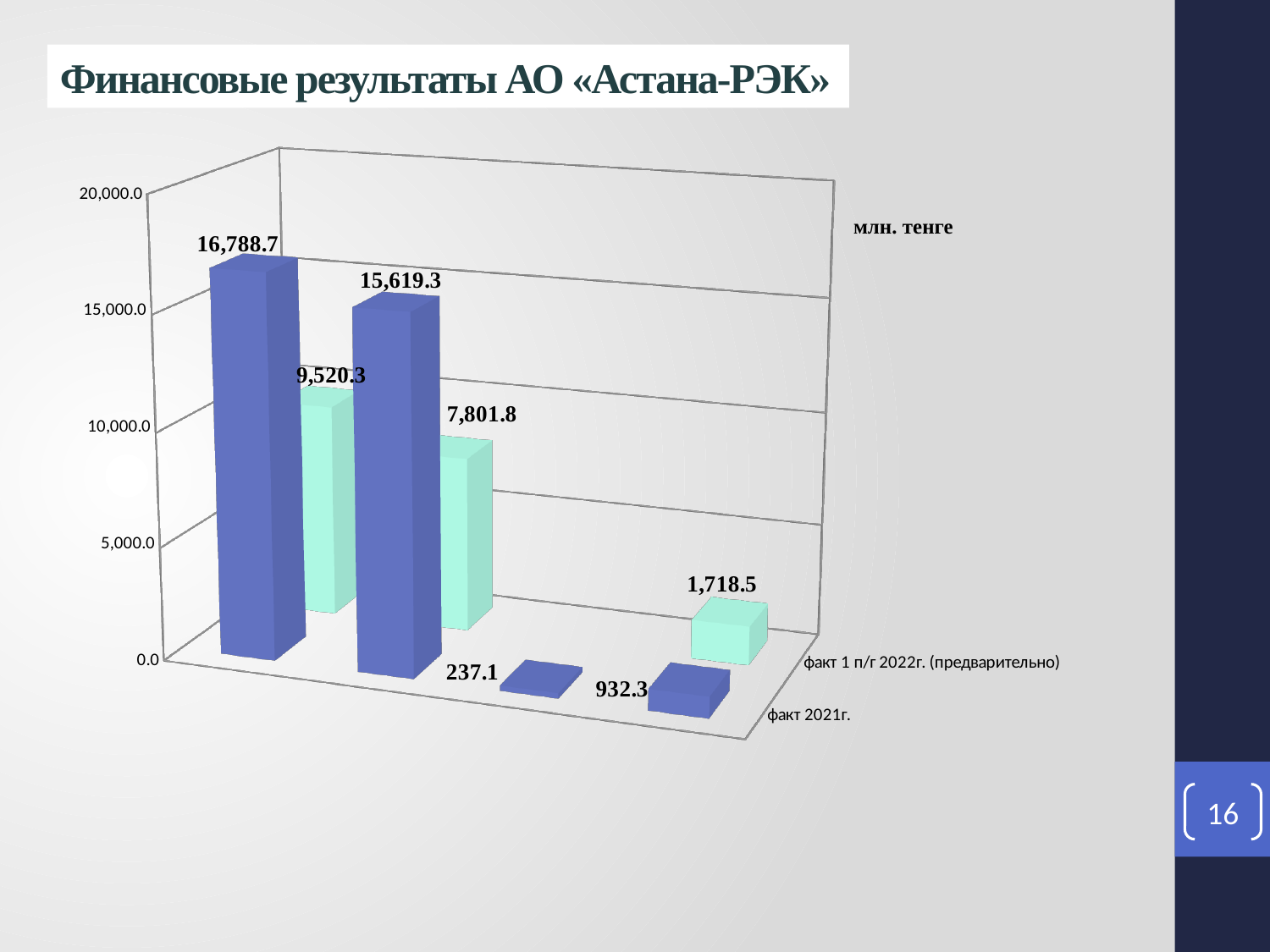
What is the highest value in the "факт 2021г." series? 16,788.7 What kind of chart is shown on the slide? bar chart What is the lowest value in the "факт 2021г." series? 237.1 What unit is indicated for the values in the chart? млн. тенге What is the highest value in the "факт 1 п/г 2022г. (предварительно)" series? 9,520.3 How many data series are plotted in the chart? 2 What is the difference between the two largest values in the "факт 2021г." series, 16,788.7 and 15,619.3? 1,169.4 How many bars are shown for the "факт 2021г." series? 4 Is the tallest bar in the chart greater or less than 15,000.0? greater Which is larger in the "факт 2021г." series: the bar labelled 932.3 or the bar labelled 237.1? 932.3 What is the lowest value in the "факт 1 п/г 2022г. (предварительно)" series? 1,718.5 What is the title of the slide's chart? Финансовые результаты АО «Астана-РЭК»